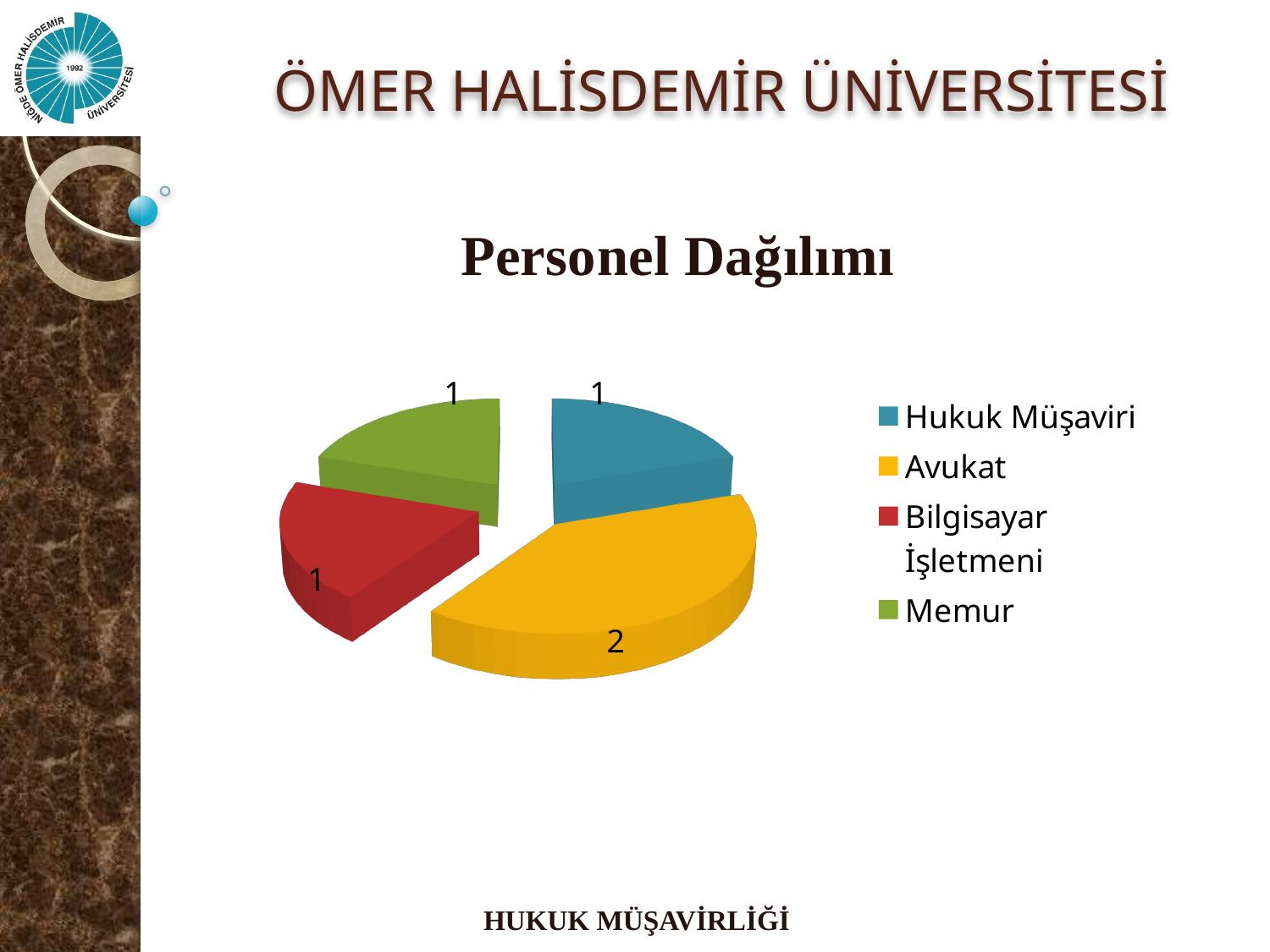
What is the value for Hukuk Müşaviri in the pie chart? 1 What is the value for Bilgisayar İşletmeni in the pie chart? 1 Which colour represents Bilgisayar İşletmeni in the pie chart? Red What is the value for Avukat in the pie chart? 2 How many categories does the pie chart show? 4 What is the title of the chart? Personel Dağılımı What is the difference between the value for Avukat and the value for Memur? 1 Which is larger, the value for Avukat or the value for Hukuk Müşaviri? Avukat What kind of chart is shown on the slide? Pie chart What share of the pie does Avukat represent? 40% What is the value for Memur in the pie chart? 1 Which category has the largest slice in the pie chart? Avukat